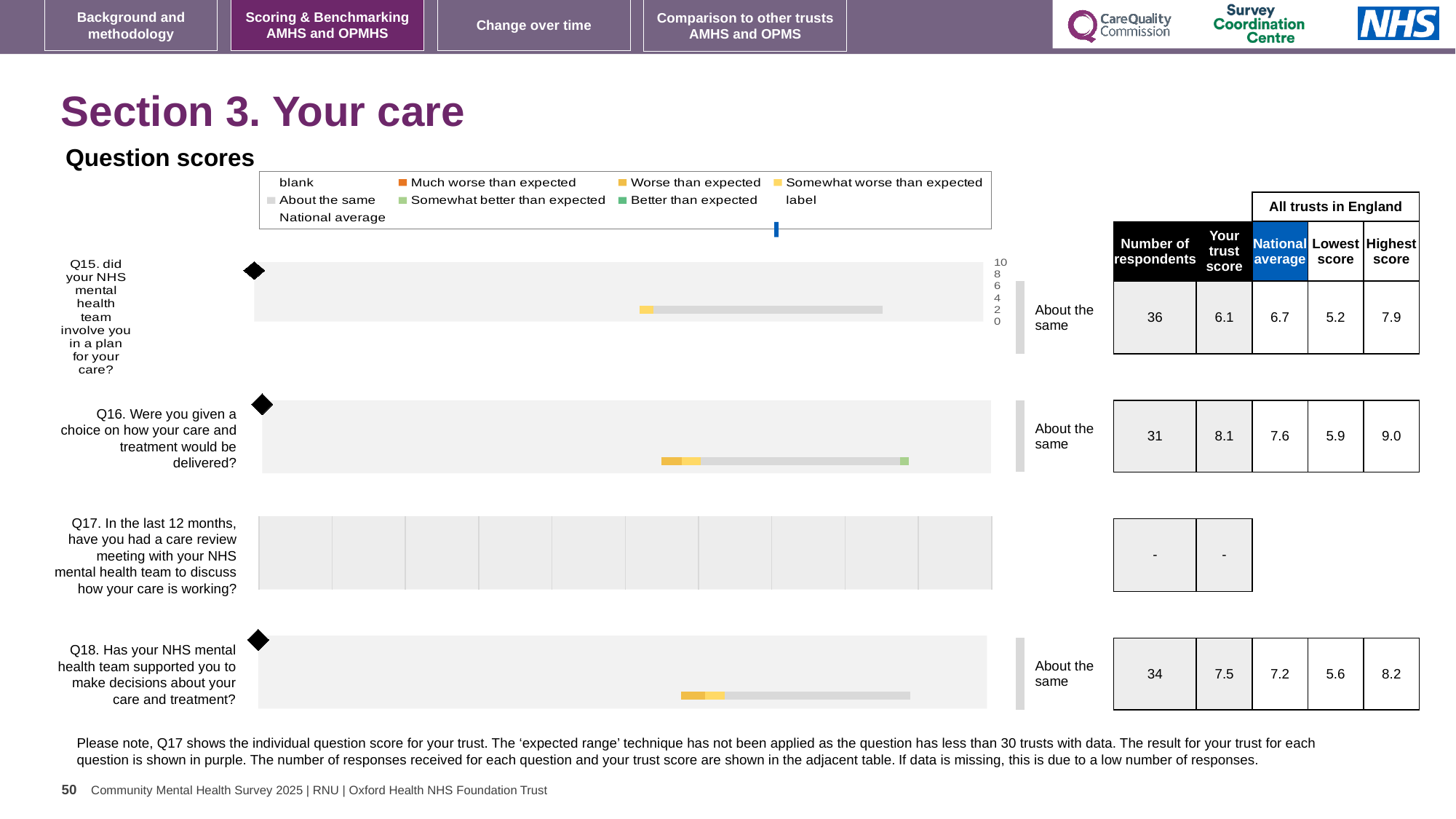
What is the national average for Q18 (Has your NHS mental health team supported you to make decisions about your care and treatment)? 7.2 What is the lowest score across all trusts in England for Q15? 5.2 How many respondents answered Q15 (did your NHS mental health team involve you in a plan for your care)? 36 What benchmark category label is shown next to the bar for Q18? About the same What is the 'Your trust score' value for Q16 (Were you given a choice on how your care and treatment would be delivered)? 8.1 For Q15, how much higher is the national average than the trust score? 0.6 For Q18, which is larger: the trust score or the national average? Your trust score (7.5) Which question has the lowest 'Your trust score'? Q15 Which question has the highest 'Your trust score'? Q16 For Q16, what is the difference between the highest score and the lowest score across all trusts in England? 3.1 How many questions (Q15 to Q18) are plotted in the question scores chart? 4 What kind of chart is used to show the question scores on this slide? bar chart